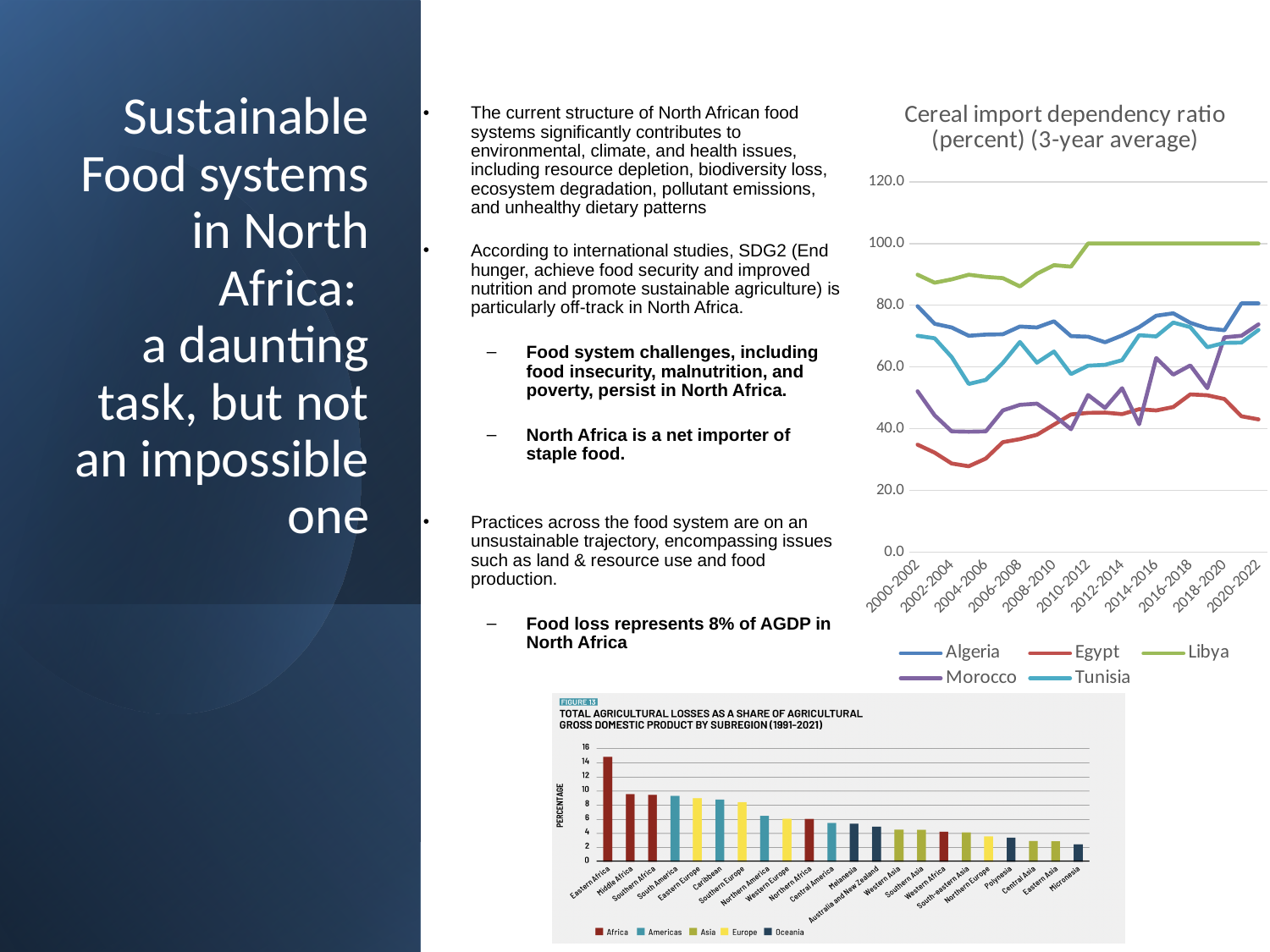
In the 'Cereal import dependency ratio' chart, is the value for Libya in 2020-2022 greater or less than 80.0? greater In the 'Cereal import dependency ratio' chart, is the value for Egypt in 2004-2006 greater or less than 40.0? less In the 'Cereal import dependency ratio' chart, which country has the lowest value in 2000-2002? Egypt In the 'Cereal import dependency ratio' chart, does the value for Morocco rise or fall overall from 2000-2002 to 2020-2022? rise In the 'Cereal import dependency ratio' chart, which is larger in 2010-2012, Libya or Egypt? Libya What type of chart is the 'Cereal import dependency ratio (percent) (3-year average)' chart? line chart What type of chart is the 'Total agricultural losses as a share of agricultural gross domestic product by subregion (1991-2021)' chart? bar chart In the 'Total agricultural losses as a share of agricultural gross domestic product by subregion' chart, which subregion has the highest value? Eastern Africa How many series does the legend of the 'Cereal import dependency ratio' chart list? 5 In the 'Cereal import dependency ratio' chart, is the value for Tunisia in 2004-2006 greater or less than 60.0? less In the 'Cereal import dependency ratio' chart, which country has the highest value in 2020-2022? Libya